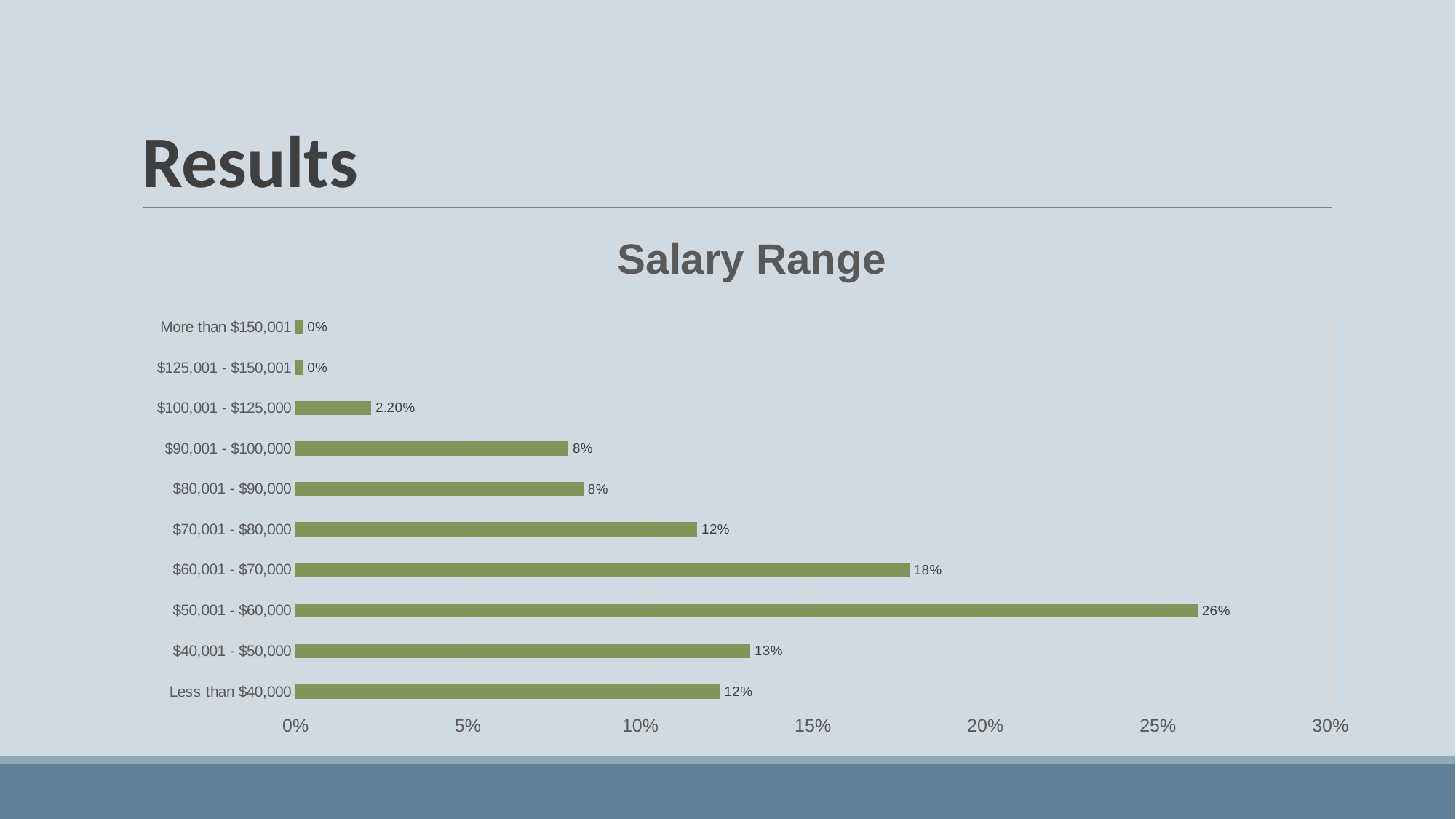
What is the value for the $60,001 - $70,000 salary range? 18% What is the value for the $40,001 - $50,000 salary range? 13% Which salary range has the highest value? $50,001 - $60,000 Which is larger, the value for $70,001 - $80,000 or the value for $90,001 - $100,000? $70,001 - $80,000 How many salary ranges have a value of 0%? 2 What is the difference between the values for $50,001 - $60,000 and $60,001 - $70,000? 8% What type of chart is shown on the slide? Bar chart What is the value for the $50,001 - $60,000 salary range? 26% How many salary range categories are shown in the chart? 10 What is the title of the chart? Salary Range Is the value for $60,001 - $70,000 greater or less than 15%? greater What is the value for the $100,001 - $125,000 salary range? 2.20%